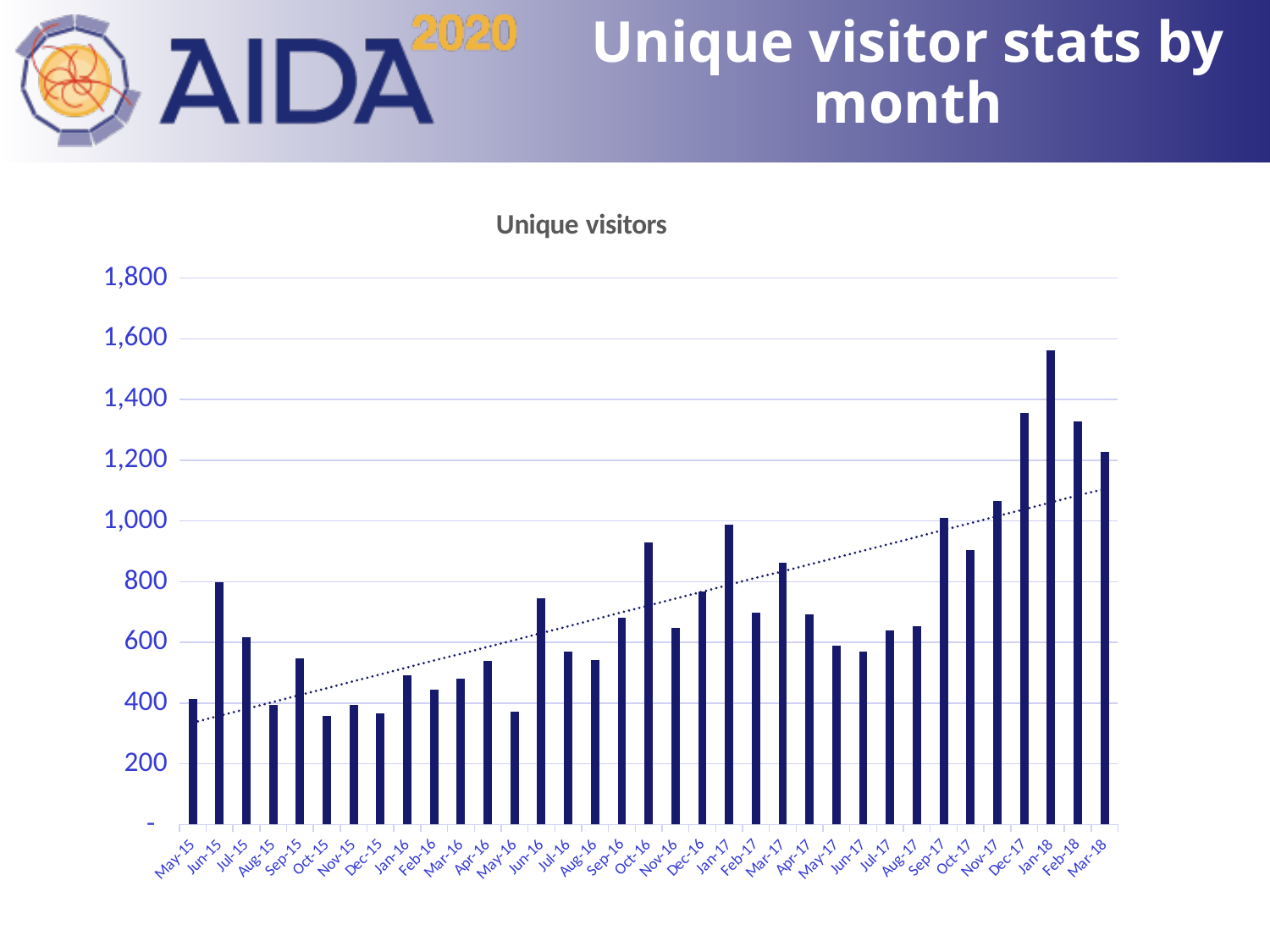
Is the value for May-15 greater or less than 600? less Which month has the highest number of unique visitors? Jan-18 Is the value for Dec-17 greater or less than 1,200? greater How many months are plotted on the x axis of the chart? 35 Is the value for Jan-18 greater or less than 1,400? greater Overall, do unique visitors rise or fall from May-15 to Mar-18? Rise What kind of chart is shown on the slide? Bar chart Which has more unique visitors, Jan-18 or Feb-18? Jan-18 What is the title of the chart? Unique visitors Which has more unique visitors, Jun-15 or Jul-15? Jun-15